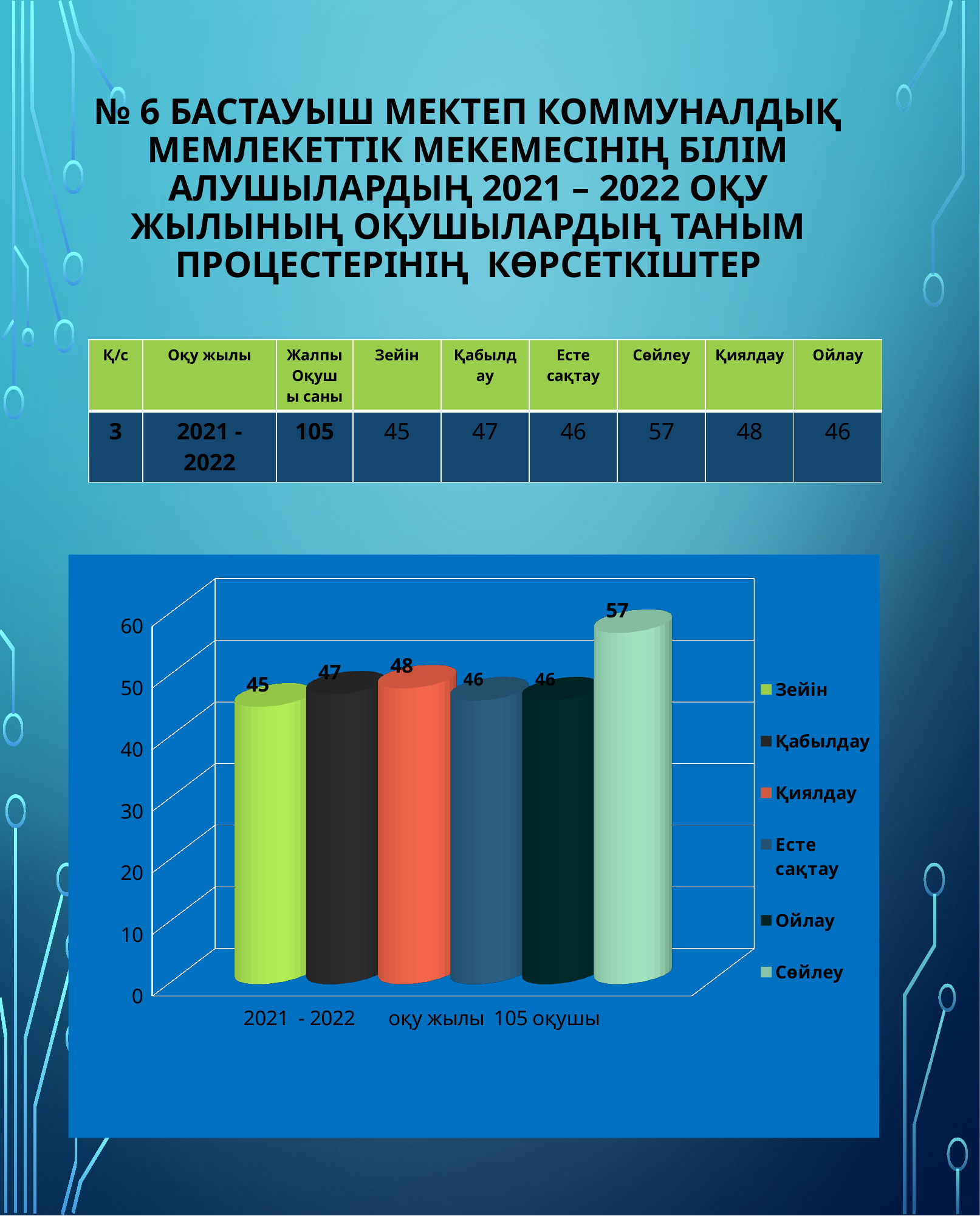
What colour is the bar for Қиялдау in the chart? orange-red What kind of chart is shown on the slide? bar chart What is the difference between the values for Сөйлеу and Зейін? 12 Is the value for Сөйлеу greater or less than 50? greater How many series does the legend list? 6 What is the value for Сөйлеу in the chart? 57 What is the value for Қиялдау in the chart? 48 Which series has the highest value in the chart? Сөйлеу What is the value for Қабылдау in the chart? 47 Which series has the lowest value in the chart? Зейін Which is larger, the value for Қиялдау or the value for Қабылдау? Қиялдау What is the value for Зейін in the chart? 45